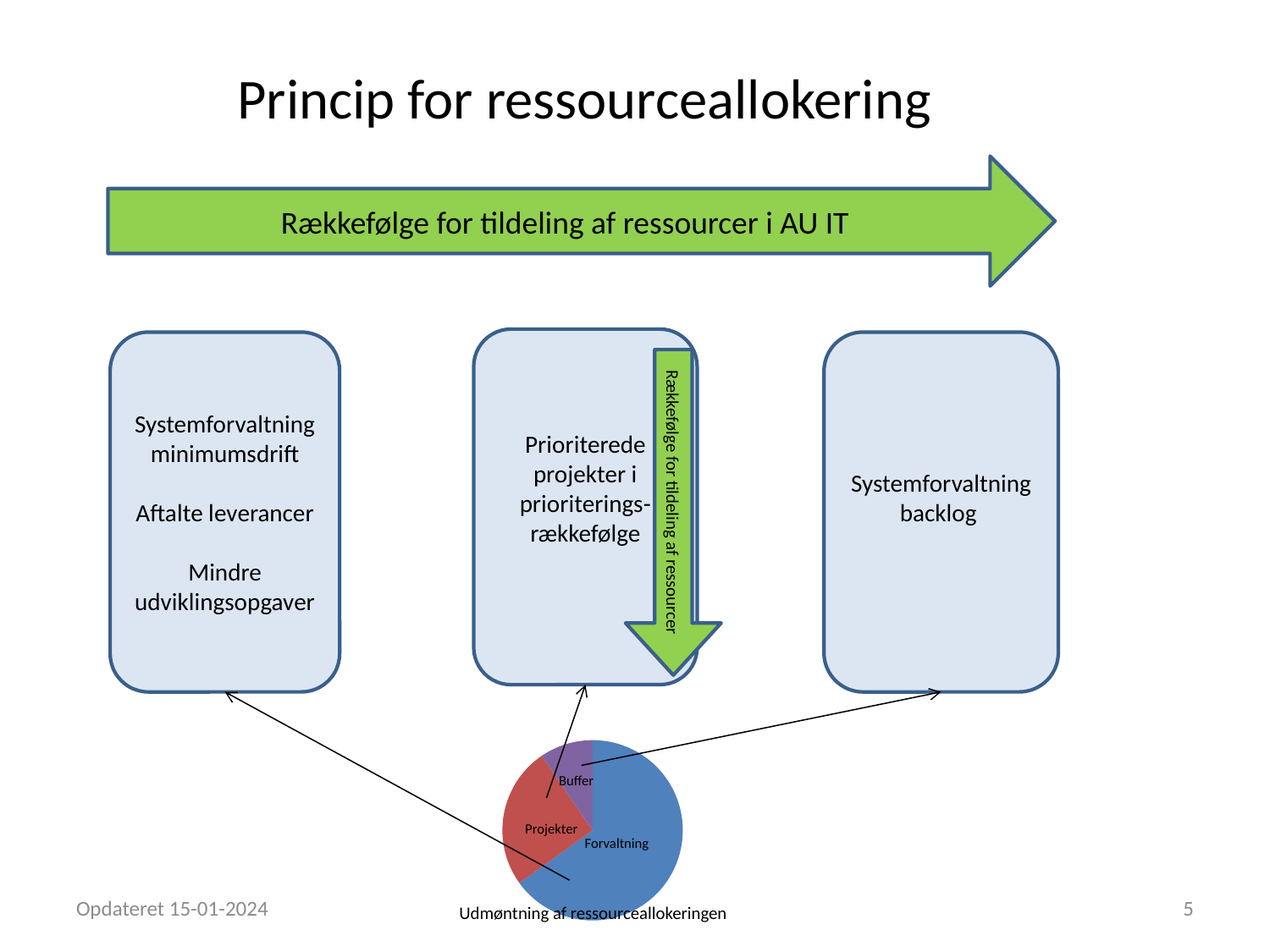
In the pie chart, which is larger: Projekter or Buffer? Projekter What colour is the Forvaltning slice in the pie chart? blue What is the title shown beneath the pie chart? Udmøntning af ressourceallokeringen Which slice of the pie chart is the largest? Forvaltning In the pie chart, which is larger: Forvaltning or Projekter? Forvaltning How many slices does the pie chart have? 3 Which slice of the pie chart is the smallest? Buffer What kind of chart is shown at the bottom of the slide? pie chart